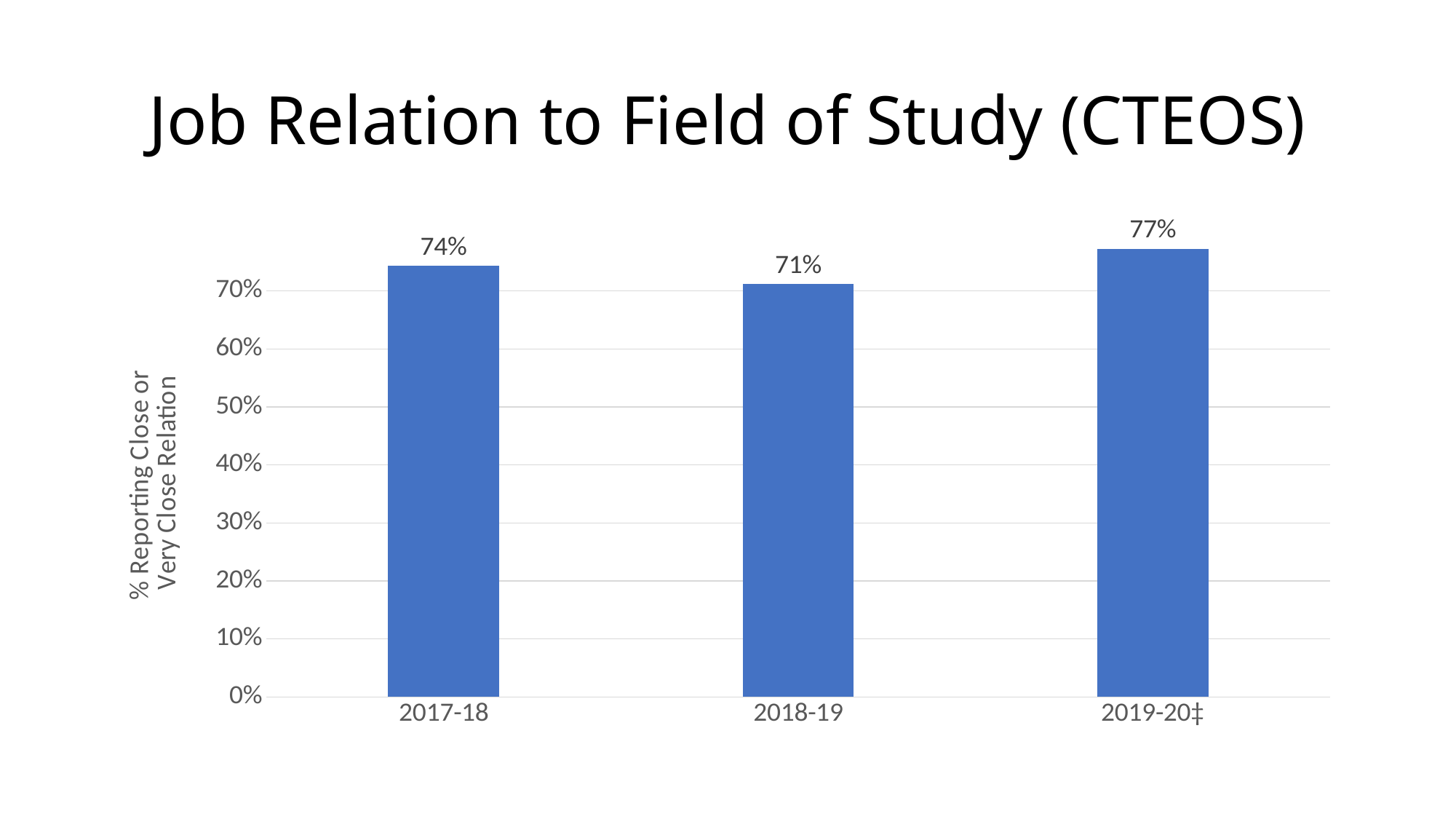
What is the difference between the values for 2017-18 and 2018-19? 3% Is the value for 2018-19 greater or less than 70%? greater What is the difference between the values for 2019-20‡ and 2018-19? 6% Which year has the highest percentage reporting close or very close relation? 2019-20‡ What is the value for 2018-19? 71% What is the value for 2017-18? 74% How many years are shown on the chart? 3 What is the value for 2019-20‡? 77% Which is larger, the value for 2017-18 or the value for 2019-20‡? 2019-20‡ What is the title of the chart? Job Relation to Field of Study (CTEOS) Which year has the lowest percentage reporting close or very close relation? 2018-19 What kind of chart is shown on the slide? Bar chart